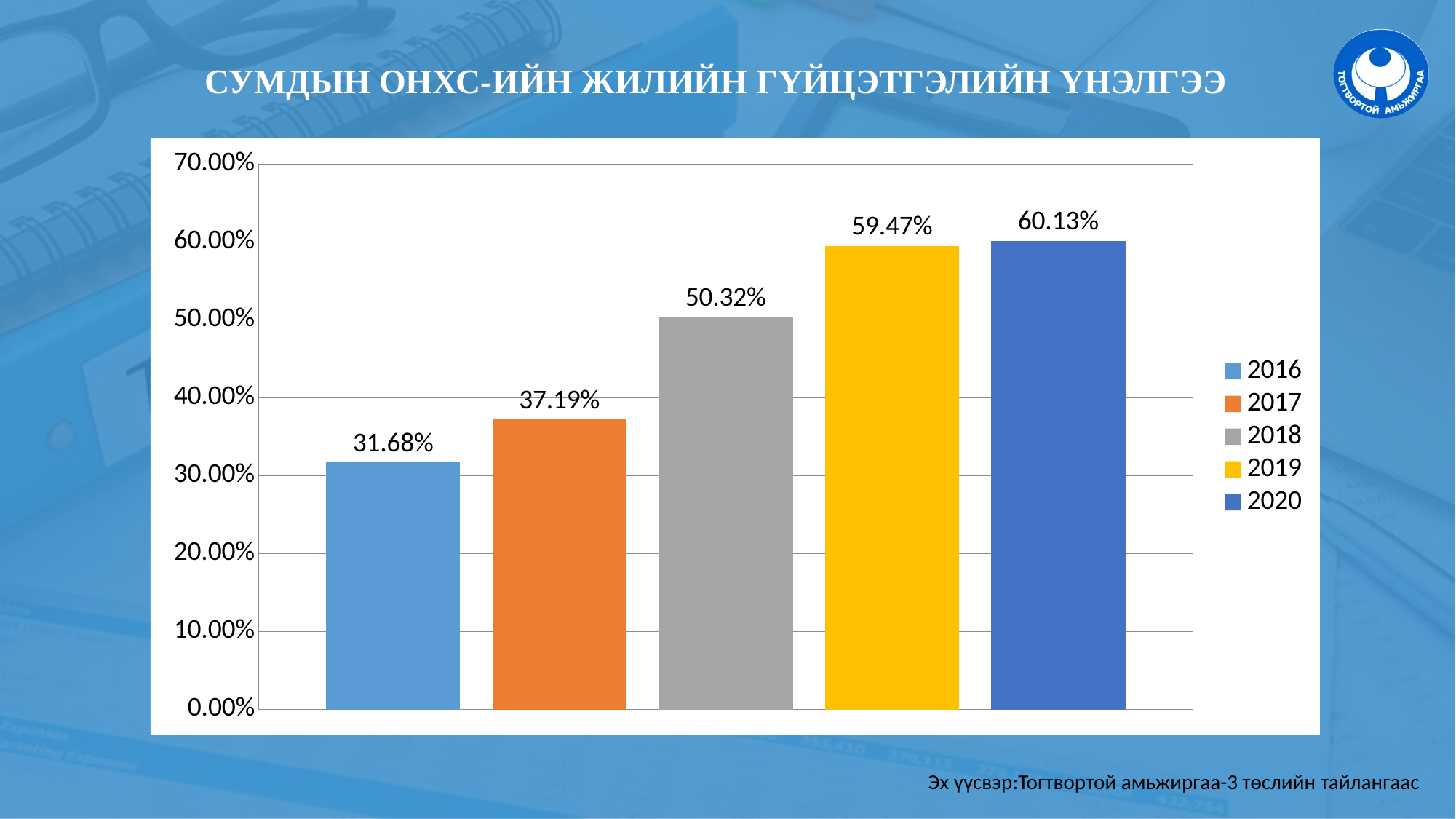
What is the difference between the values for 2018 and 2017? 13.13% How many bars are plotted in the chart? 5 What is the value for 2018? 50.32% How many entries does the legend list? 5 Do the values rise or fall from 2016 to 2020? rise Which is larger, the value for 2019 or the value for 2017? 2019 Which year has the lowest value? 2016 What kind of chart is shown on the slide? bar chart What is the value for 2016? 31.68% Which year has the highest value? 2020 What is the value for 2020? 60.13% What is the difference between the values for 2020 and 2016? 28.45%